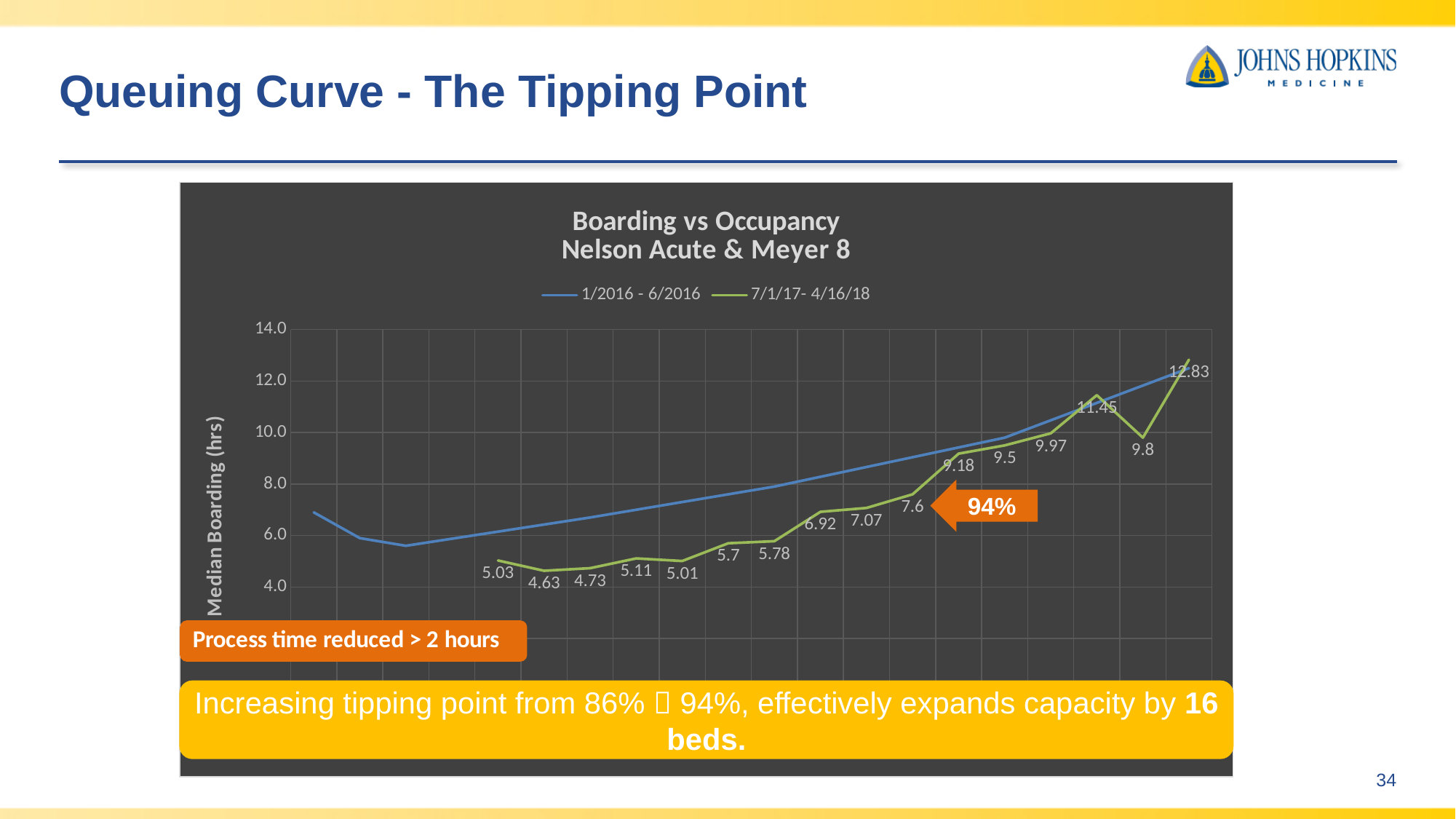
What is the difference between the points labeled 9.97 and 9.5 on the 7/1/17- 4/16/18 series? 0.47 How many series does the legend of the Boarding vs Occupancy chart list? 2 What are the two series named in the legend of the chart? 1/2016 - 6/2016 and 7/1/17- 4/16/18 On the 7/1/17- 4/16/18 series, which is larger: the point labeled 9.8 or the point labeled 11.45? 11.45 Is the lowest point of the 1/2016 - 6/2016 series greater or less than 6.0? less How many labeled data points are on the 7/1/17- 4/16/18 series? 16 Overall, do the values of the 7/1/17- 4/16/18 series rise or fall from left to right? Rise What is the label on the vertical axis of the chart? Median Boarding (hrs) What is the difference between the highest labeled value (12.83) and the value 11.45 on the 7/1/17- 4/16/18 series? 1.38 What is the highest labeled value on the 7/1/17- 4/16/18 series? 12.83 What kind of chart is shown on the slide? Line chart What is the lowest labeled value on the 7/1/17- 4/16/18 series? 4.63